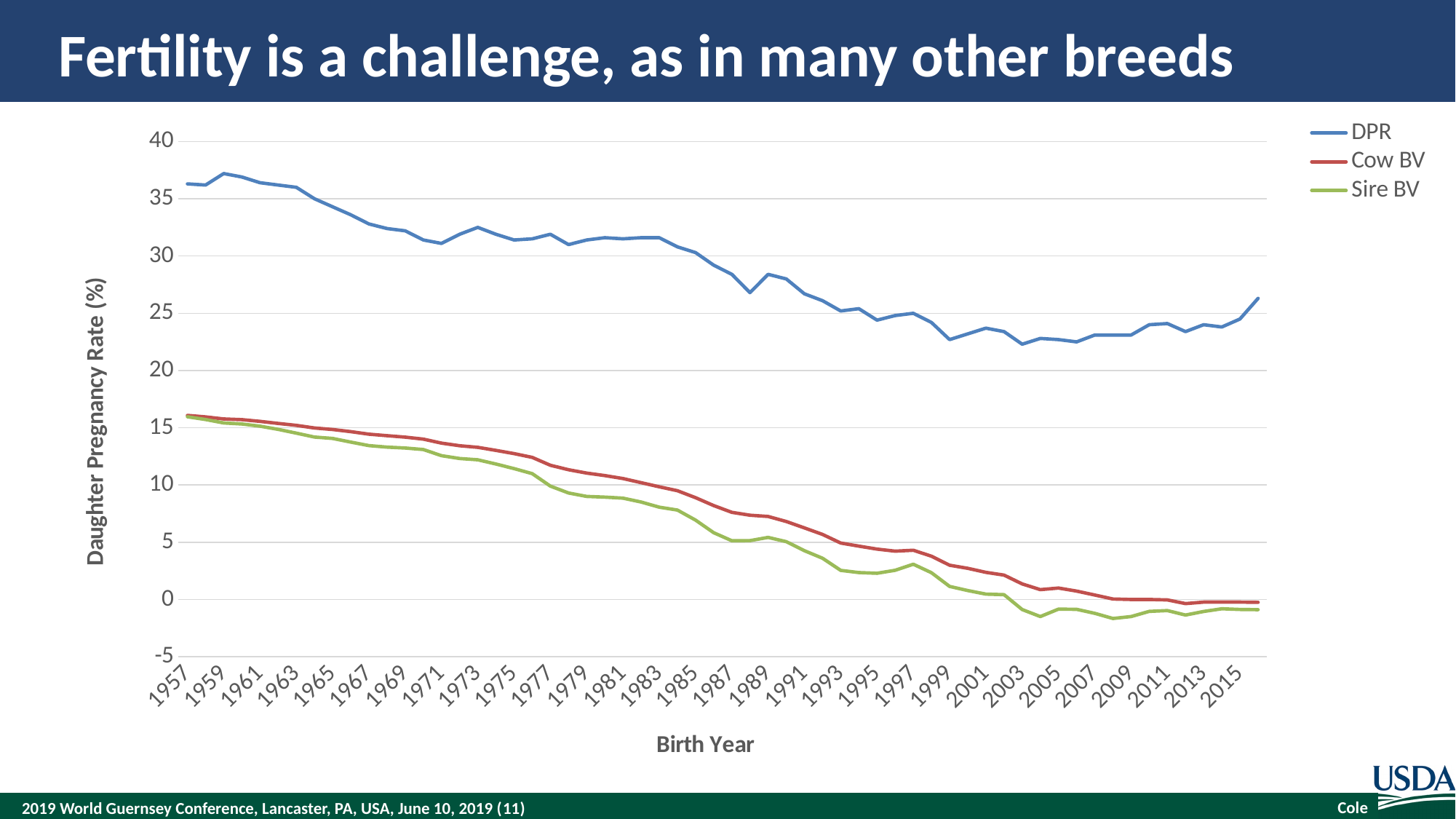
Is the Sire BV value for 2005 greater or less than 0? less Is the DPR value for 1957 greater or less than 35? greater What kind of chart is shown on the slide? line chart Which series has the highest values throughout the chart? DPR Is the DPR value for 2003 greater or less than 25? less In 1987, which is larger, Cow BV or Sire BV? Cow BV Does the DPR series rise or fall overall from 1957 to 2015? fall What are the three series listed in the legend? DPR, Cow BV, Sire BV Does the Sire BV series rise or fall overall across the birth years shown? fall How many series does the legend list? 3 What is the label of the y axis? Daughter Pregnancy Rate (%)